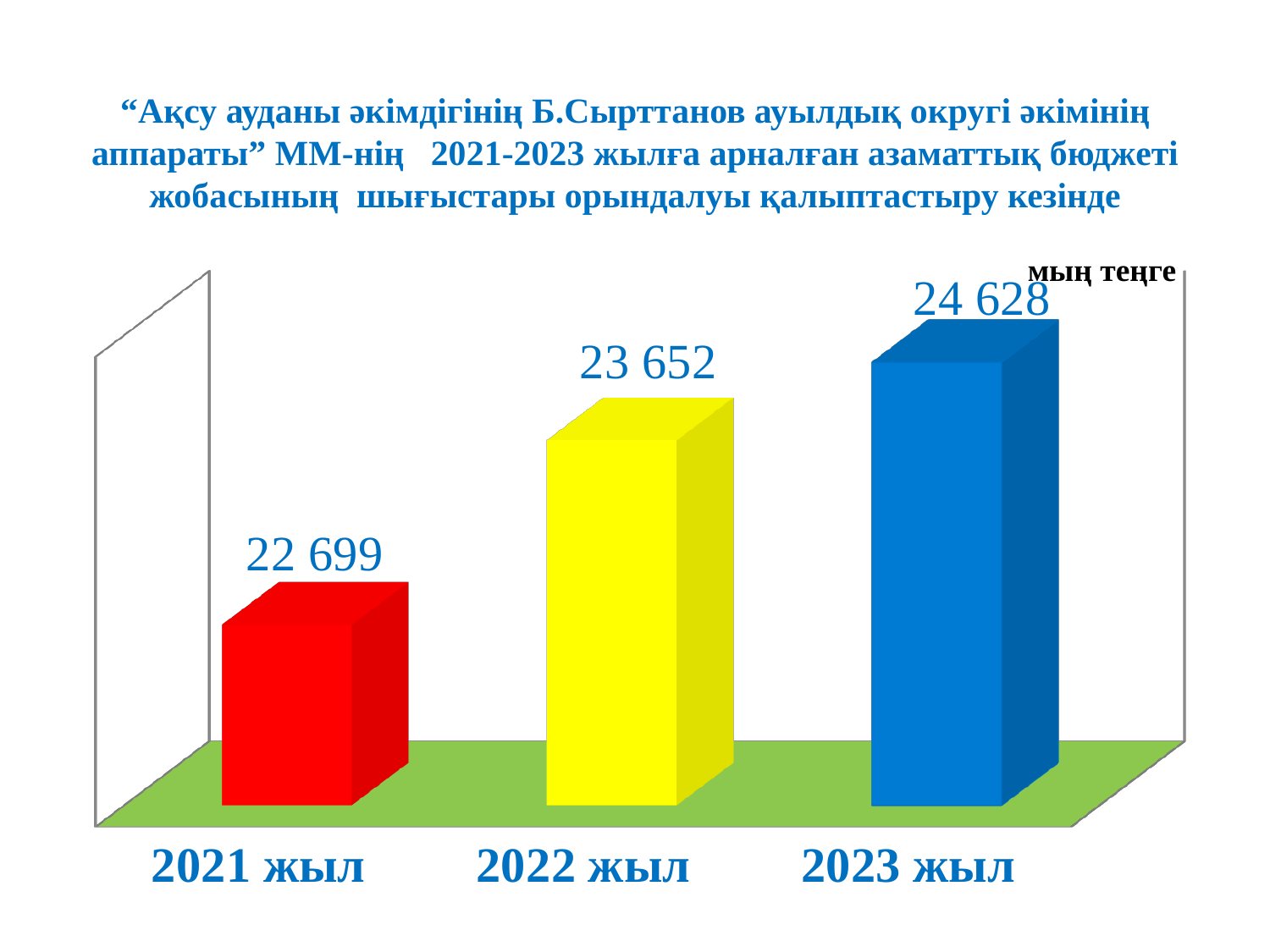
What is the difference between the values for 2022 жыл and 2021 жыл? 953 What is the value for 2023 жыл? 24 628 What is the value for 2021 жыл? 22 699 What kind of chart is shown on the slide? bar chart Do the values rise or fall from 2021 жыл to 2023 жыл? rise What unit is indicated in the top right corner of the chart? мың теңге What is the value for 2022 жыл? 23 652 How many years are shown in the chart? 3 Which year has the lowest value? 2021 жыл Which is larger, the value for 2022 жыл or the value for 2023 жыл? 2023 жыл What is the difference between the values for 2023 жыл and 2021 жыл? 1 929 Which year has the highest value? 2023 жыл